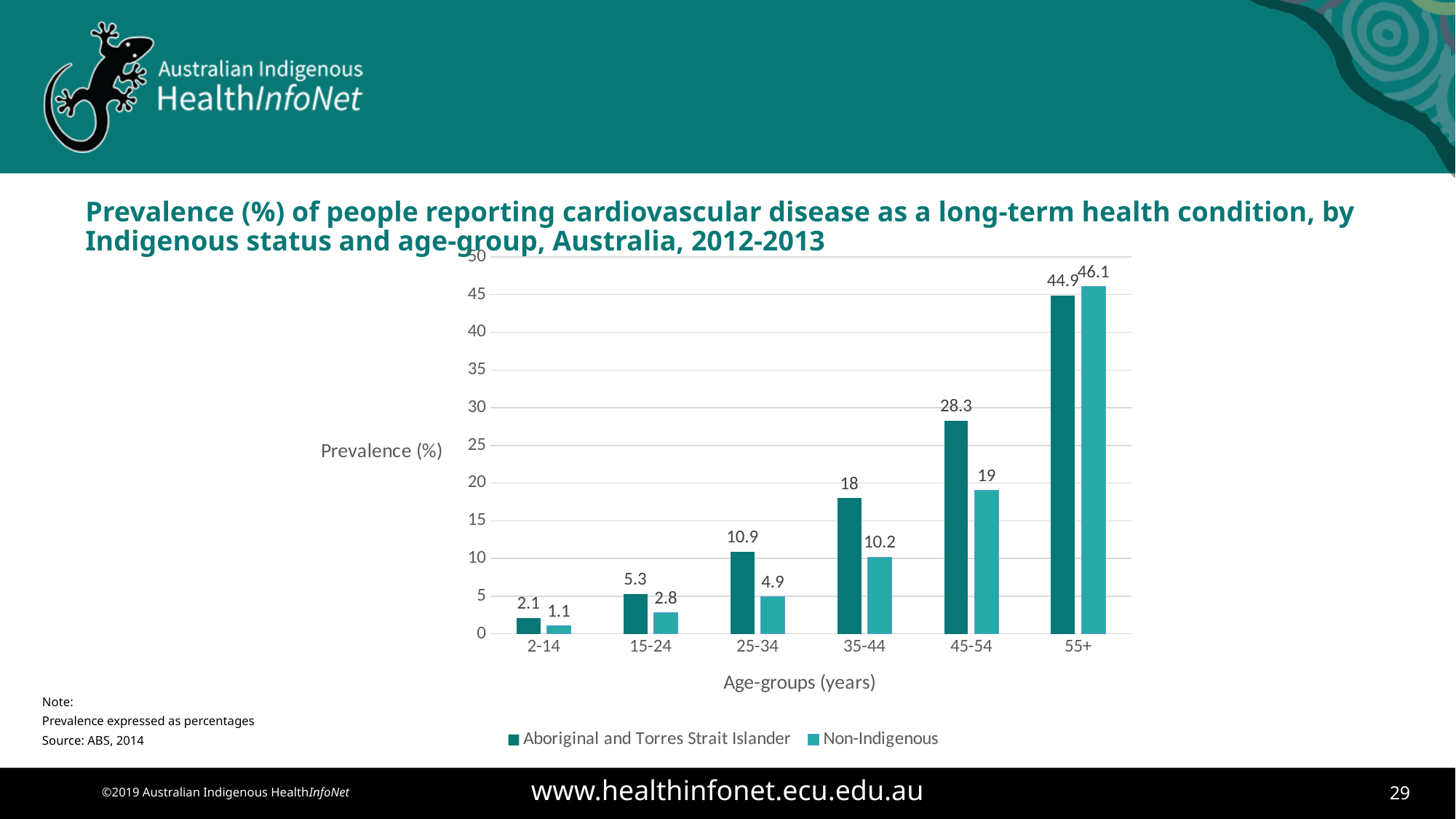
What is the prevalence (%) for Non-Indigenous people aged 2-14? 1.1 What kind of chart is shown on the slide? bar chart What is the prevalence (%) for Non-Indigenous people aged 25-34? 4.9 Is the Aboriginal and Torres Strait Islander prevalence for the 35-44 age-group greater or less than 20? less What is the difference between the Aboriginal and Torres Strait Islander and Non-Indigenous prevalence for the 45-54 age-group? 9.3 How many series does the legend list? 2 Which age-group has the lowest prevalence for the Aboriginal and Torres Strait Islander series? 2-14 Which age-group has the highest prevalence for the Non-Indigenous series? 55+ Does the Non-Indigenous prevalence rise or fall as age-group increases from 2-14 to 55+? rise What is the prevalence (%) for Aboriginal and Torres Strait Islander people aged 45-54? 28.3 For the 15-24 age-group, which series has the larger prevalence: Aboriginal and Torres Strait Islander or Non-Indigenous? Aboriginal and Torres Strait Islander How many age-groups are shown on the x axis? 6